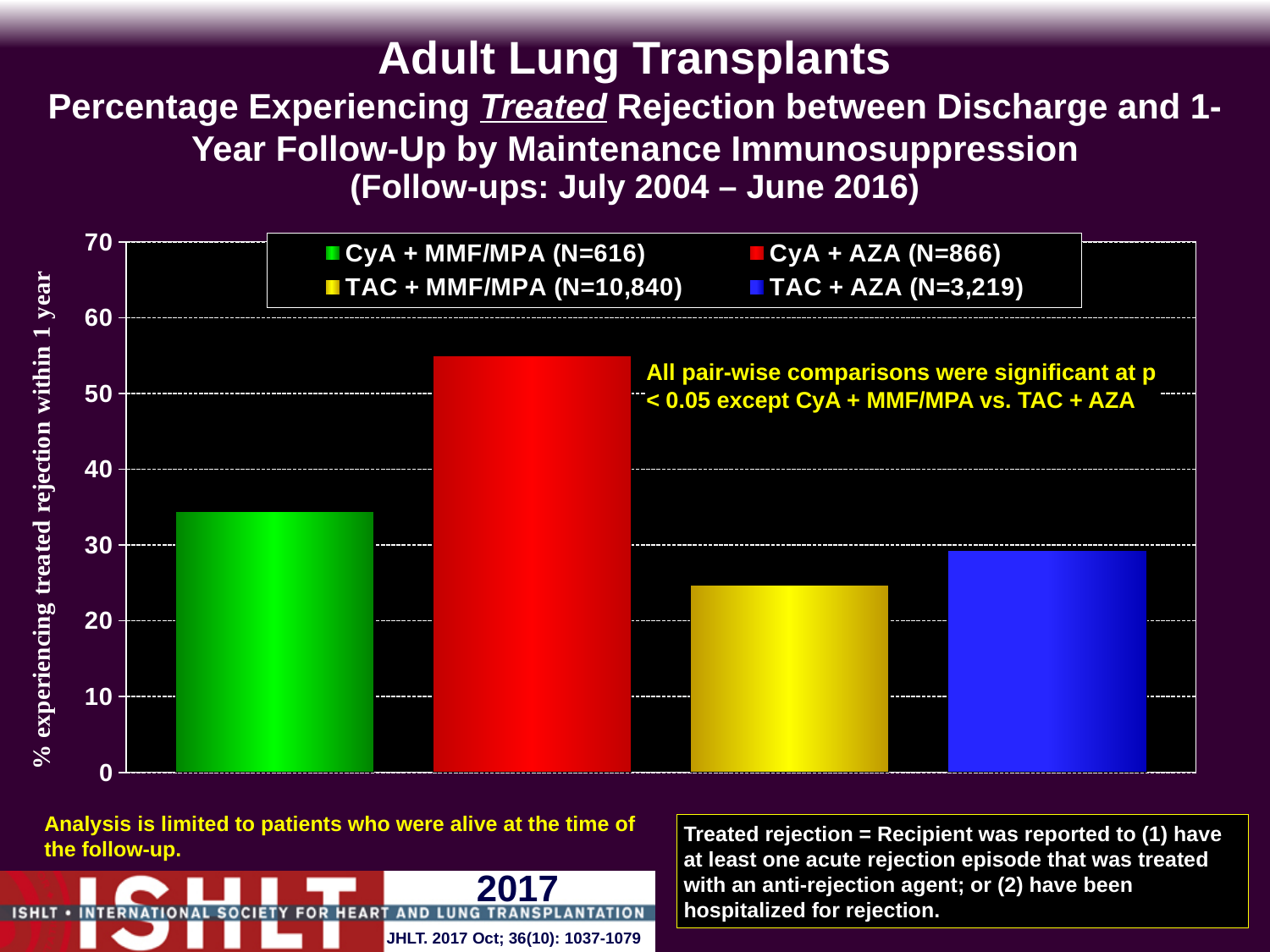
Which maintenance immunosuppression group has the highest percentage experiencing treated rejection? CyA + AZA What colour is the bar for CyA + AZA? red According to the legend, what is the N for the TAC + MMF/MPA group? 10,840 Which group has a higher percentage experiencing treated rejection, TAC + AZA or TAC + MMF/MPA? TAC + AZA Is the value for TAC + MMF/MPA greater or less than 30? less Is the value for CyA + MMF/MPA greater or less than 30? greater Which group has a higher percentage experiencing treated rejection, CyA + MMF/MPA or TAC + AZA? CyA + MMF/MPA What kind of chart is shown on the slide? bar chart Which maintenance immunosuppression group has the lowest percentage experiencing treated rejection? TAC + MMF/MPA How many series does the legend list? 4 Is the value for CyA + AZA greater or less than 50? greater How many bars are plotted in the chart? 4